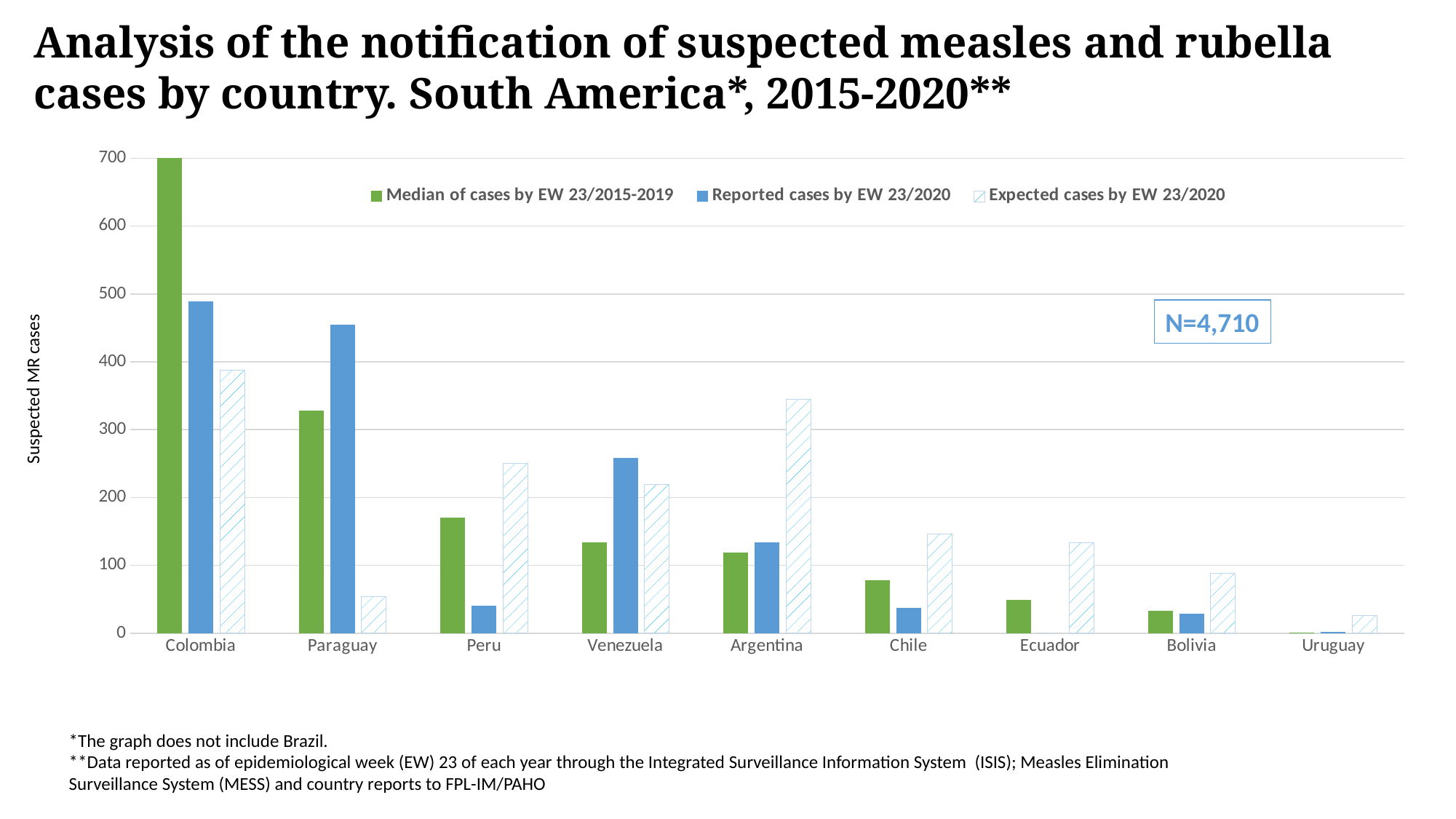
How many series does the chart's legend list? 3 Which country has the highest reported cases by EW 23/2020? Colombia What kind of chart is shown on the slide? Bar chart For Peru, which is larger: reported cases by EW 23/2020 or expected cases by EW 23/2020? Expected cases by EW 23/2020 What N value is shown in the box on the chart? N=4,710 Is the value of reported cases by EW 23/2020 for Paraguay greater or less than 400? greater How many countries are shown on the x axis of the chart? 9 Is the median of cases by EW 23/2015-2019 for Chile greater or less than 100? less For Venezuela, which is larger: reported cases by EW 23/2020 or expected cases by EW 23/2020? Reported cases by EW 23/2020 Which country has the lowest expected cases by EW 23/2020? Uruguay Which country has the highest median of cases by EW 23/2015-2019? Colombia Is the value of expected cases by EW 23/2020 for Argentina greater or less than 300? greater